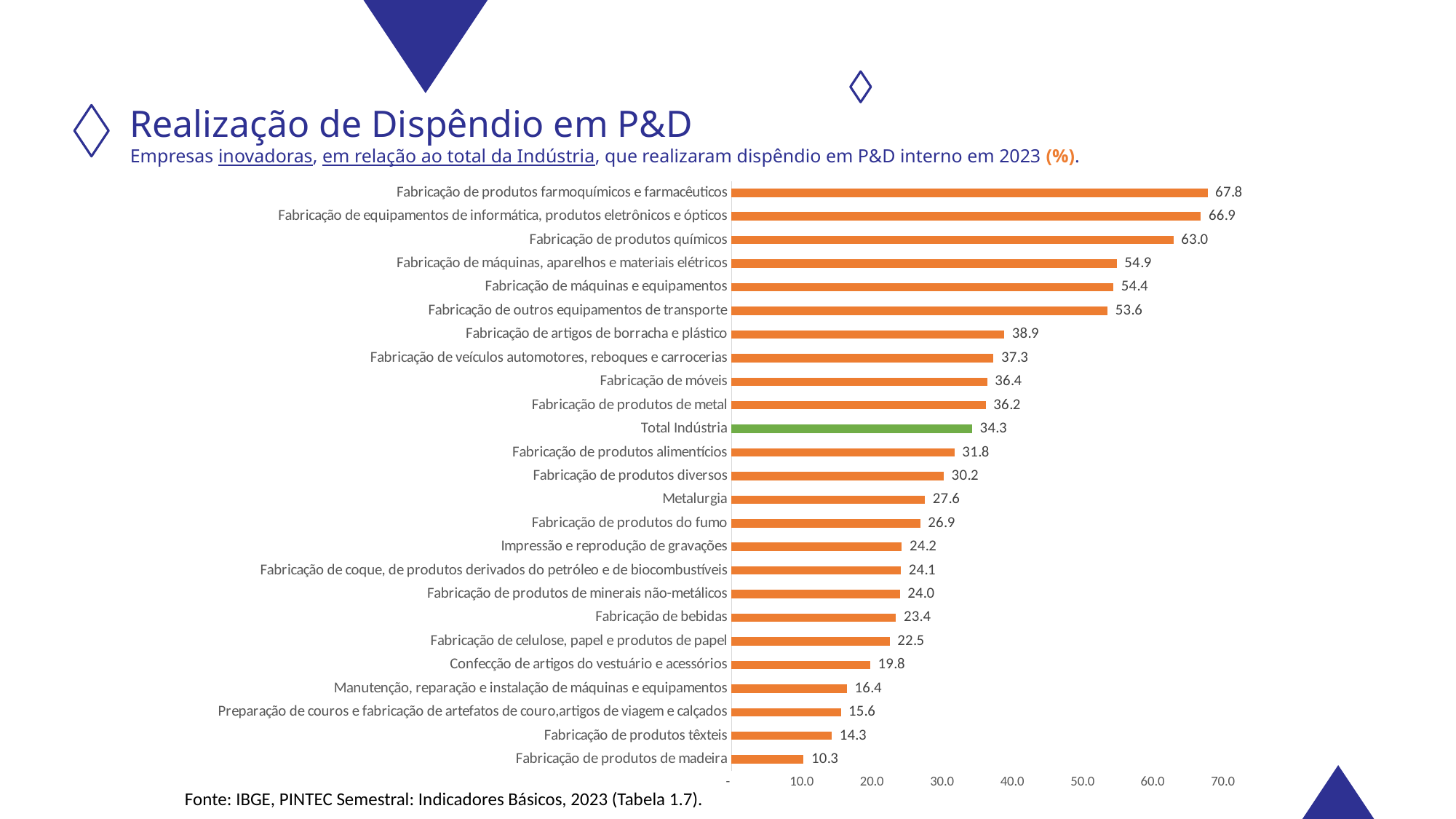
Which category has the highest value? Fabricação de produtos farmoquímicos e farmacêuticos Is the value for Fabricação de artigos de borracha e plástico greater or less than 40.0? less Which bar is shown in green rather than orange? Total Indústria What is the value for Metalurgia? 27.6 Which category has the lowest value? Fabricação de produtos de madeira How many categories are plotted in the chart? 25 What is the value for Fabricação de produtos farmoquímicos e farmacêuticos? 67.8 What kind of chart is shown on the slide? Bar chart What is the difference between Fabricação de produtos químicos and Fabricação de produtos de madeira? 52.7 What is the value for Fabricação de produtos têxteis? 14.3 Which is larger: Fabricação de móveis or Fabricação de produtos de metal? Fabricação de móveis What is the value for Total Indústria? 34.3